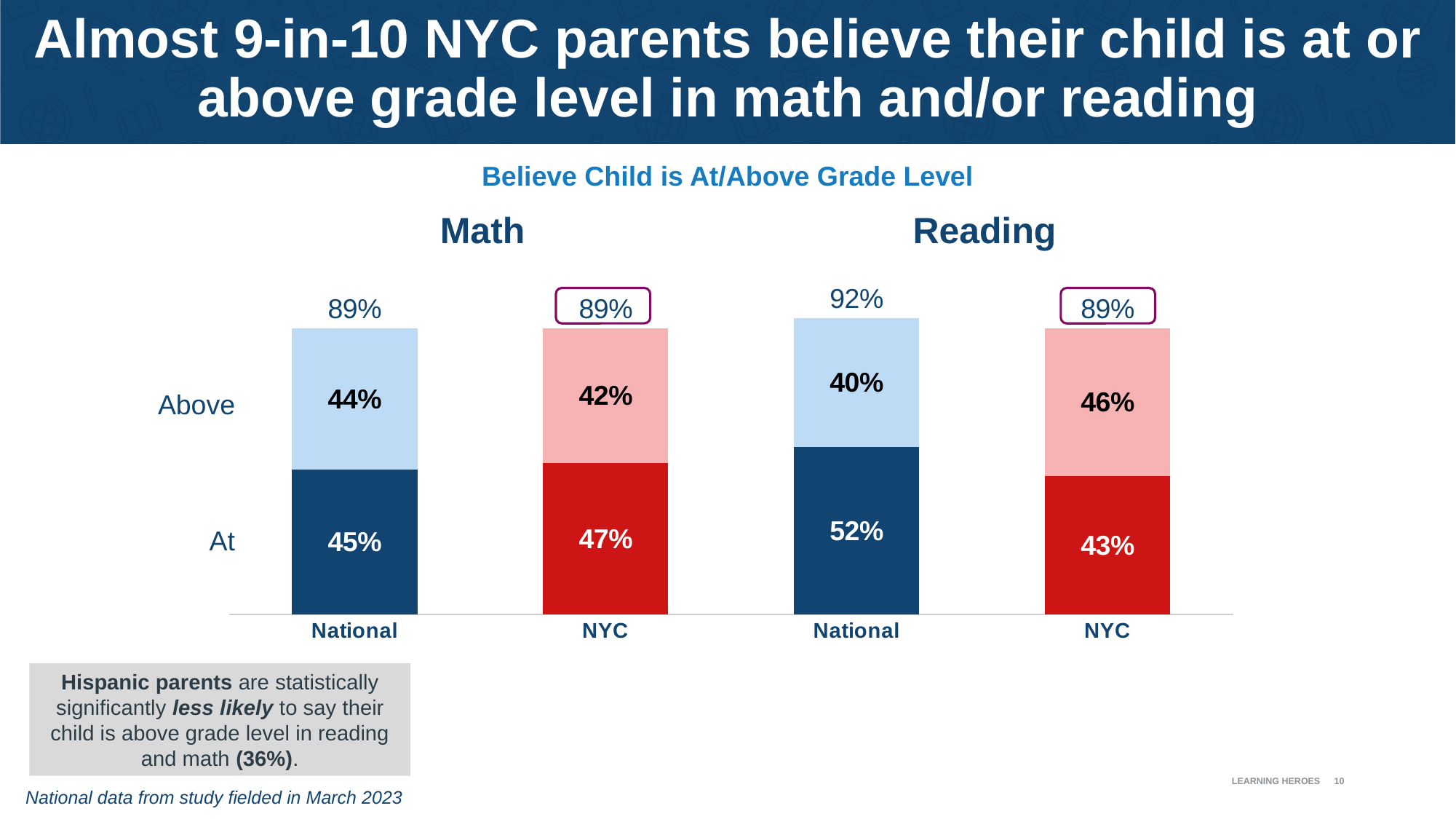
What percentage of National parents say their child is at grade level in Math? 45% What is the total percentage of NYC parents who believe their child is at or above grade level in Math? 89% Which bar has the highest total percentage of parents believing their child is at or above grade level? National (Reading) What percentage of National parents say their child is at grade level in Reading? 52% How many bars are shown in the chart? 4 In Math, which is larger: the 'Above' percentage for National or for NYC? National What is the difference between the 'At' percentage for NYC and National in Reading? 9% What are the two segment categories labeled on the left of the chart? Above and At What is the title of the chart? Believe Child is At/Above Grade Level What percentage of NYC parents say their child is above grade level in Reading? 46% What is the total percentage of National parents who believe their child is at or above grade level in Reading? 92% What type of chart is shown on the slide? Stacked bar chart